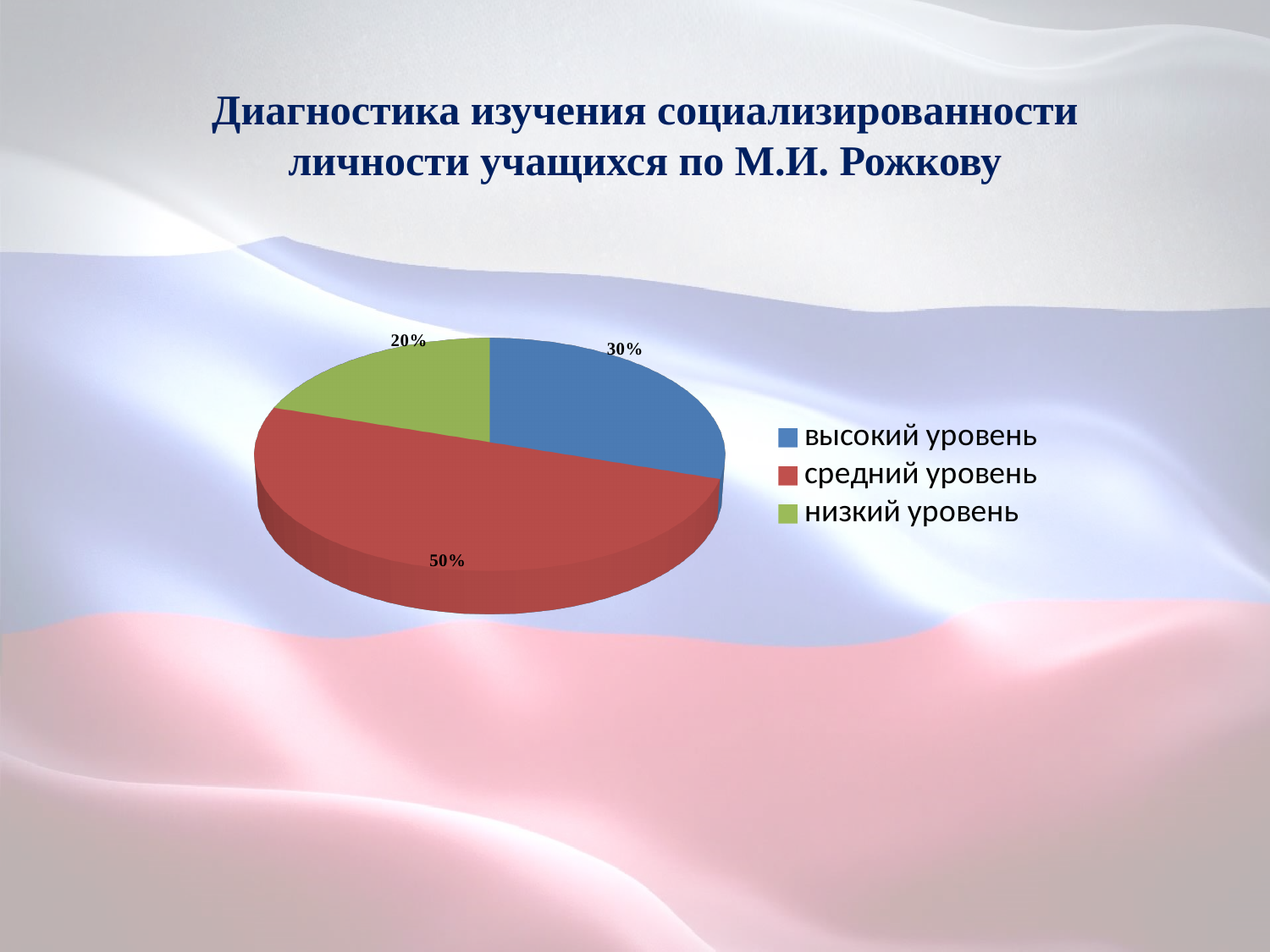
What is the value for высокий уровень? 30% What is the value for средний уровень? 50% Which category has the largest slice? средний уровень What is the difference between the values for средний уровень and высокий уровень? 20% What share of the pie does средний уровень take? 50% What kind of chart is shown on the slide? pie chart What is the difference between the values for высокий уровень and низкий уровень? 10% Which is larger, высокий уровень or низкий уровень? высокий уровень What is the value for низкий уровень? 20% What colour is the slice for низкий уровень? green How many slices does the pie chart have? 3 Which category has the smallest slice? низкий уровень